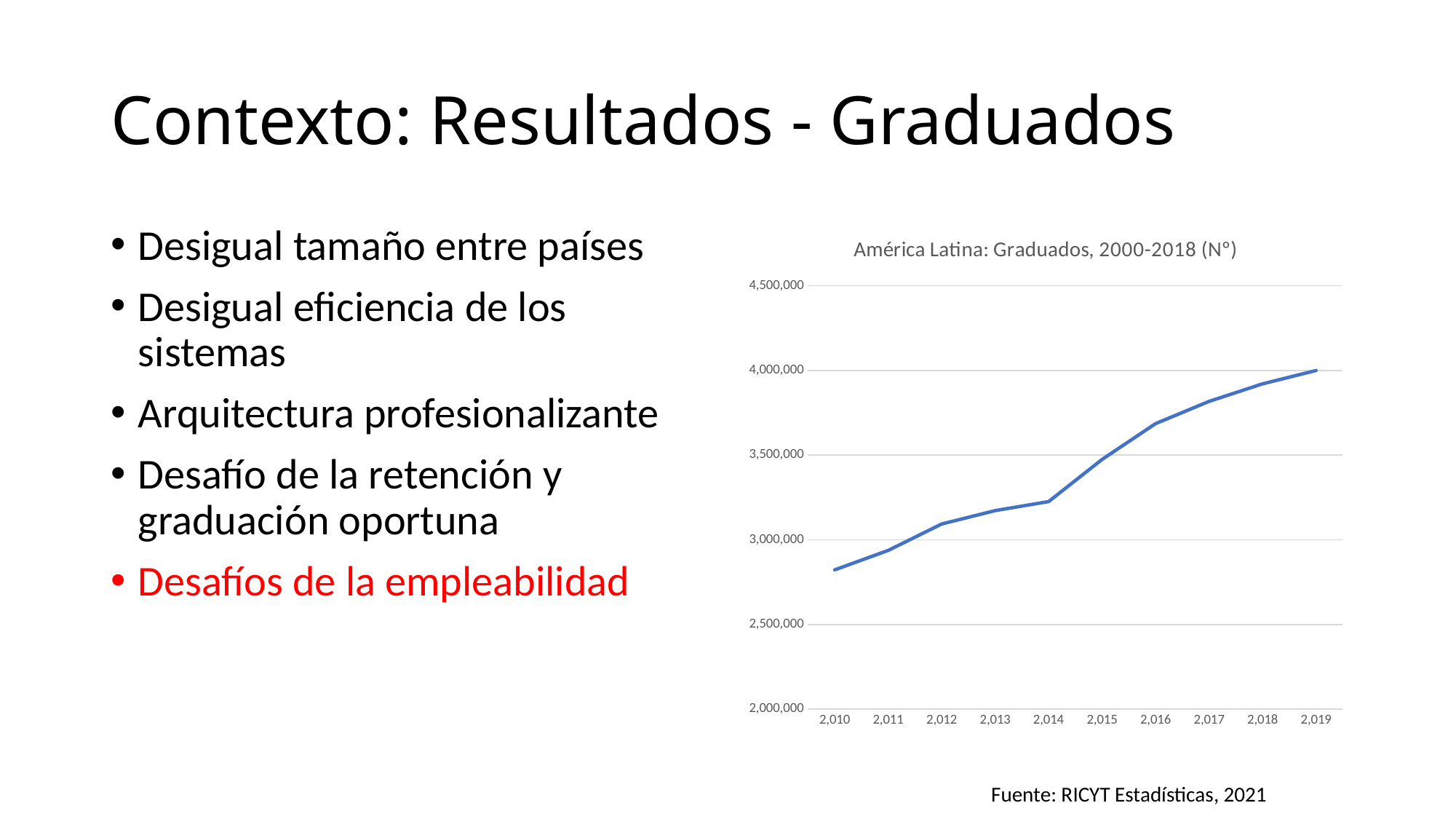
What kind of chart is shown on the slide? line chart What source is cited below the chart? Fuente: RICYT Estadísticas, 2021 What is the title of the chart? América Latina: Graduados, 2000-2018 (N°) Which year has the lowest value in the chart? 2,010 Which year has the highest value in the chart? 2,019 Is the value for 2,010 greater or less than 3,000,000? less Is the value for 2,014 greater or less than 3,000,000? greater Which year has the larger value, 2,012 or 2,017? 2,017 Is the value for 2,016 greater or less than 3,500,000? greater Do the values in the chart rise or fall from 2,010 to 2,019? rise How many years are plotted along the x axis of the chart? 10